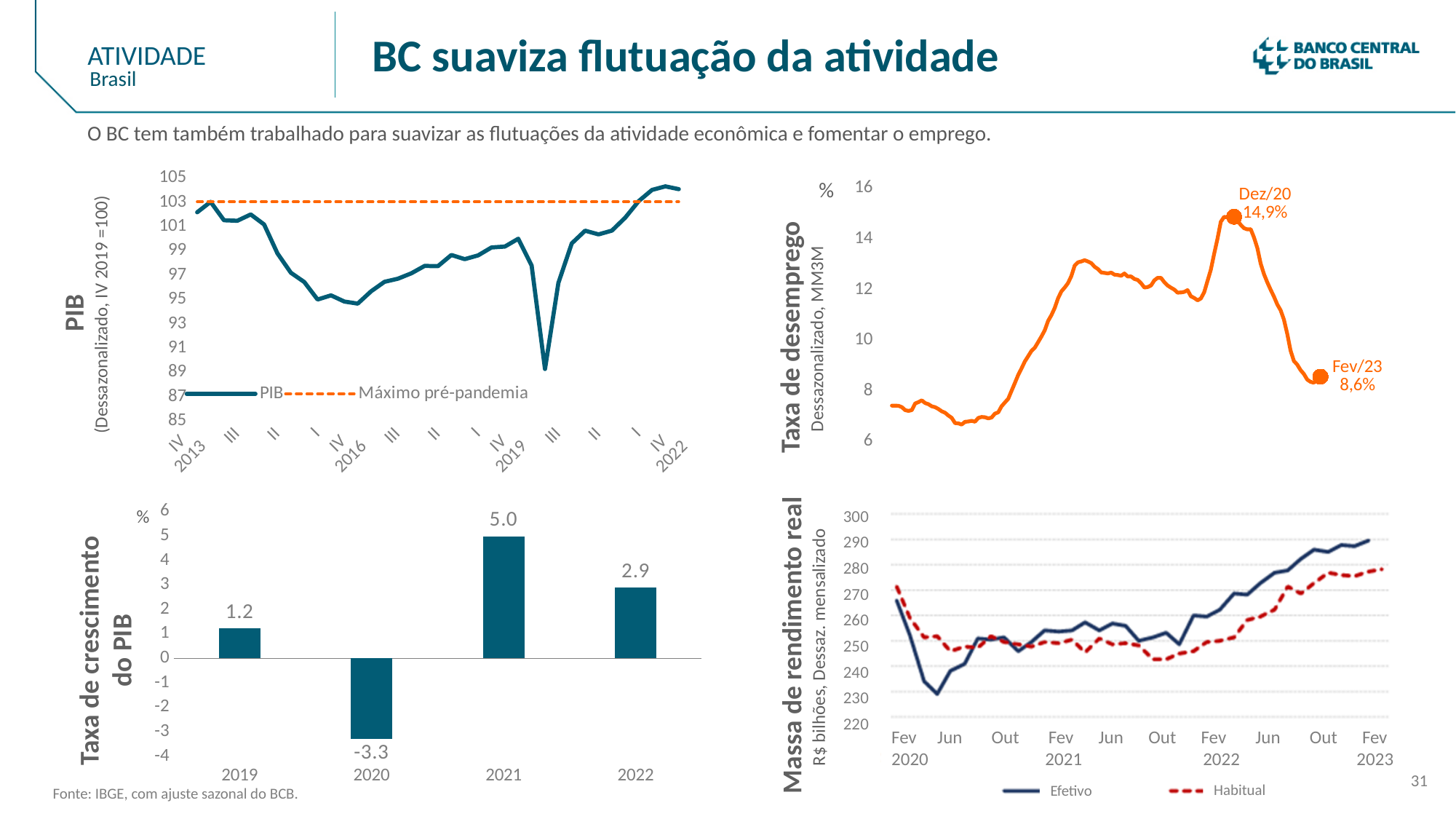
In the 'Taxa de crescimento do PIB' chart, which year has the lowest growth rate? 2020 In the 'Taxa de crescimento do PIB' chart, which year has the highest growth rate? 2021 How many series does the legend of the 'Massa de rendimento real' chart list? 2 In the 'Taxa de crescimento do PIB' chart, how many years are shown? 4 What are the two legend entries in the 'PIB' chart at the top left? PIB and Máximo pré-pandemia In the 'Taxa de desemprego' chart, what is the unemployment rate labelled for Fev/23? 8,6% In the 'Taxa de crescimento do PIB' chart, what is the difference between the 2021 and 2022 values? 2.1 In the 'Taxa de desemprego' chart, what is the unemployment rate labelled for Dez/20? 14,9% In the 'Taxa de desemprego' chart, does the unemployment rate rise or fall between Dez/20 and Fev/23? fall In the 'Taxa de crescimento do PIB' chart, what is the value for 2020? -3.3 In the 'Taxa de crescimento do PIB' chart, what is the value for 2021? 5.0 What kind of chart is the 'Taxa de crescimento do PIB' chart? bar chart